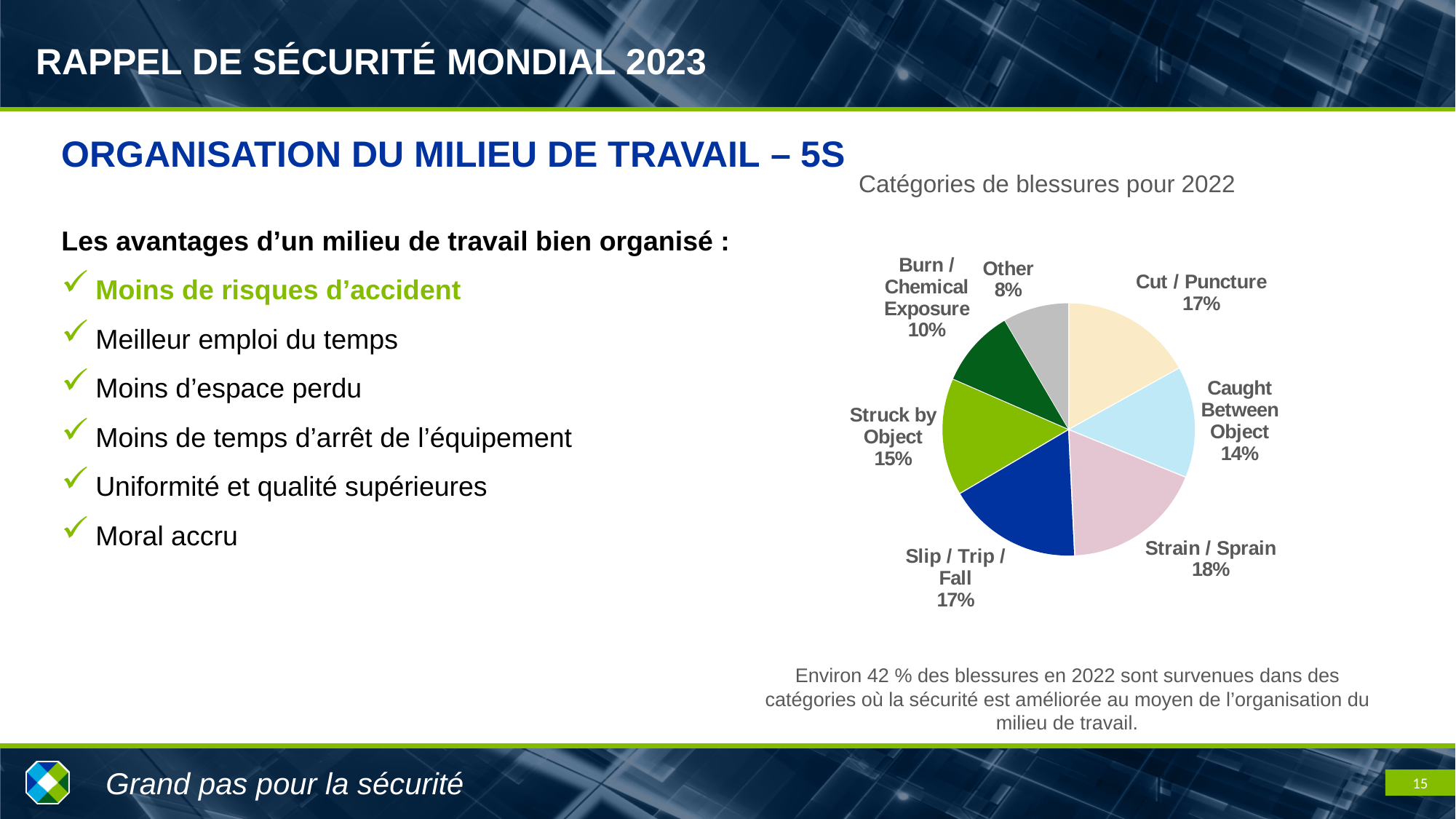
Which injury category has the largest share of the pie? Strain / Sprain What is the difference in percentage points between Strain / Sprain and Caught Between Object? 4 What type of chart is shown on the slide? Pie chart What colour is the Slip / Trip / Fall slice? Dark blue What is the combined share of Cut / Puncture and Slip / Trip / Fall? 34% What share does the Other category represent? 8% What share of injuries is attributed to Strain / Sprain? 18% What is the title of the chart? Catégories de blessures pour 2022 How many categories are shown in the pie chart? 7 What percentage of the pie is Burn / Chemical Exposure? 10% Which is larger, the share for Struck by Object or the share for Caught Between Object? Struck by Object Which injury category has the smallest share of the pie? Other